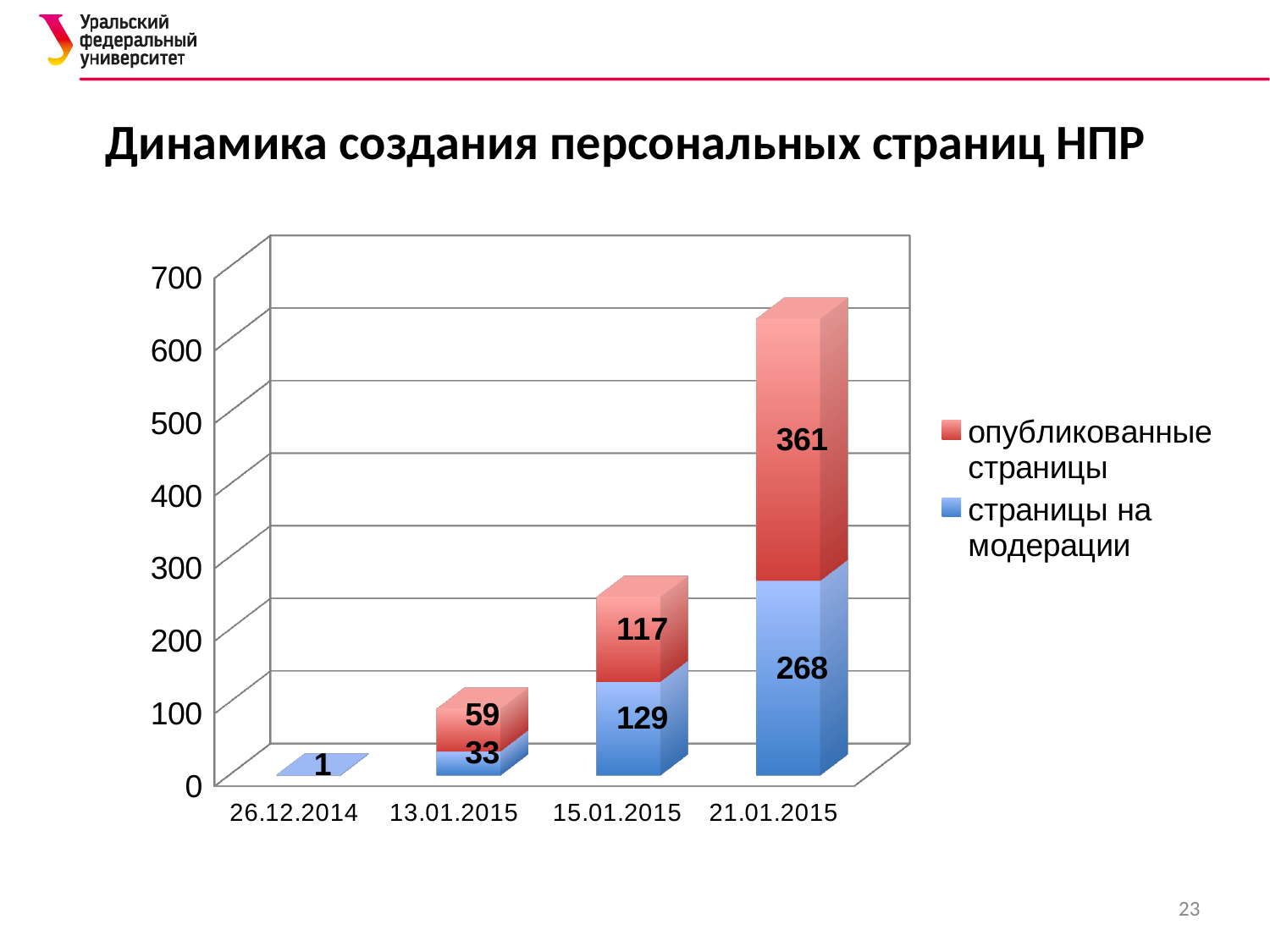
What is the value of 'опубликованные страницы' for 15.01.2015? 117 What is the total height of the stacked bar for 15.01.2015? 246 What is the difference between 'опубликованные страницы' and 'страницы на модерации' on 21.01.2015? 93 How many series does the legend list? 2 Do the values of 'страницы на модерации' rise or fall from 26.12.2014 to 21.01.2015? rise On which date is the value of 'опубликованные страницы' highest? 21.01.2015 What is the value of 'страницы на модерации' for 21.01.2015? 268 What is the title of the chart? Динамика создания персональных страниц НПР What is the value of 'страницы на модерации' for 13.01.2015? 33 On which date is the value of 'страницы на модерации' lowest? 26.12.2014 What type of chart is shown on the slide? stacked bar chart How many dates are shown on the x axis? 4